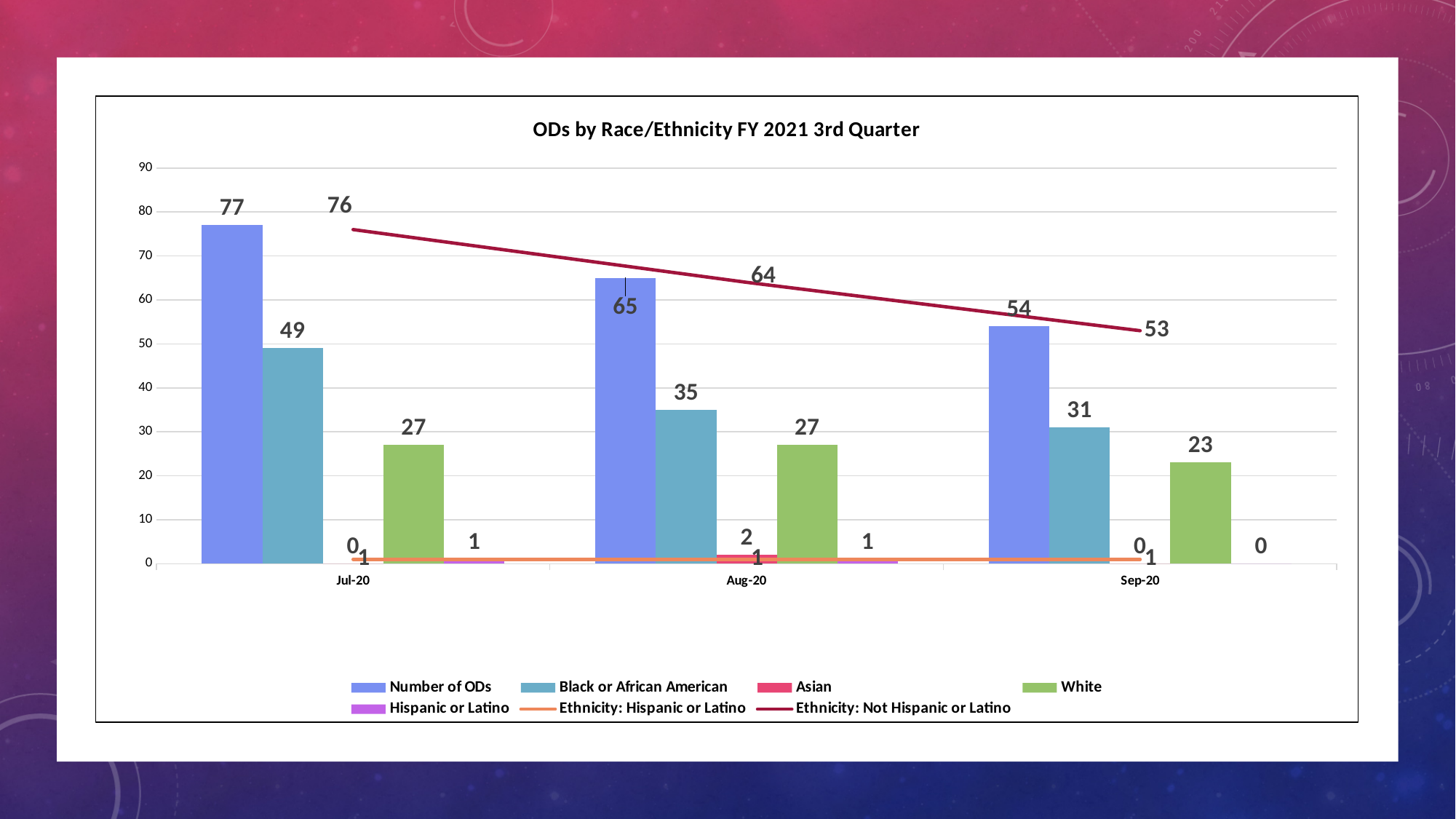
What is the Number of ODs for Jul-20? 77 Does the Ethnicity: Not Hispanic or Latino line rise or fall from Jul-20 to Sep-20? fall How many series does the legend list? 7 What is the value for White in Sep-20? 23 Which month has the lowest value for Black or African American? Sep-20 What is the title of the chart? ODs by Race/Ethnicity FY 2021 3rd Quarter What is the difference between the Number of ODs in Jul-20 and Sep-20? 23 Which month has the highest Number of ODs? Jul-20 What is the value for Ethnicity: Not Hispanic or Latino in Aug-20? 64 How many months are shown on the x axis? 3 What is the value for Black or African American in Aug-20? 35 In Jul-20, which is larger: the value for White or the value for Black or African American? Black or African American